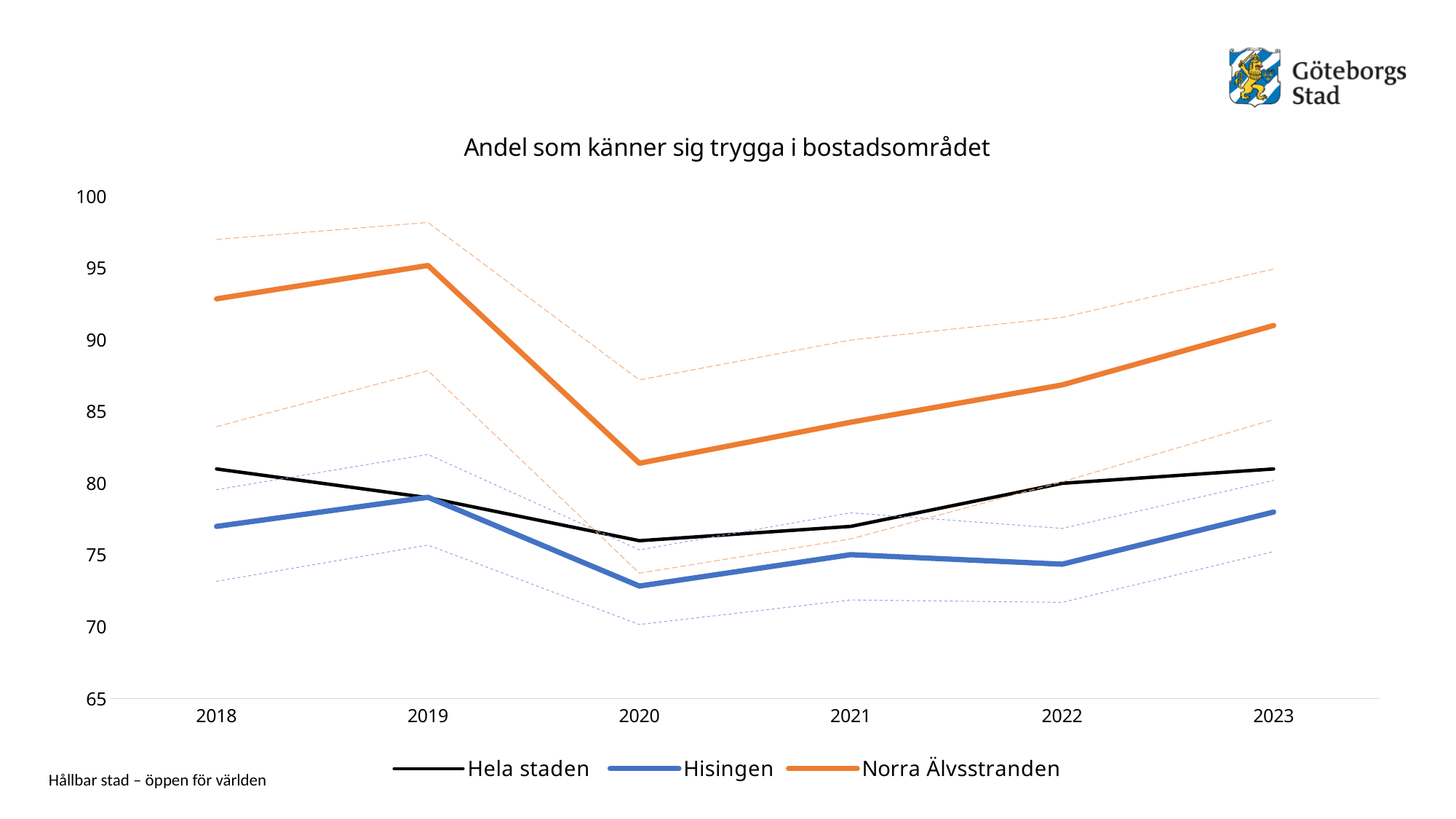
In which year is the value for Hisingen lowest? 2020 How many years are shown on the x axis? 6 Does the value for Norra Älvsstranden rise or fall from 2020 to 2023? rise In which year is the value for Norra Älvsstranden lowest? 2020 What kind of chart is shown on the slide? line chart How many series does the legend list? 3 What is the title of the chart? Andel som känner sig trygga i bostadsområdet Is the value for Hisingen in 2020 greater or less than 75? less In which year is the value for Norra Älvsstranden highest? 2019 Which series has the higher value in 2020, Norra Älvsstranden or Hisingen? Norra Älvsstranden Is the value for Norra Älvsstranden in 2018 greater or less than 90? greater Is the value for Norra Älvsstranden in 2020 greater or less than 85? less